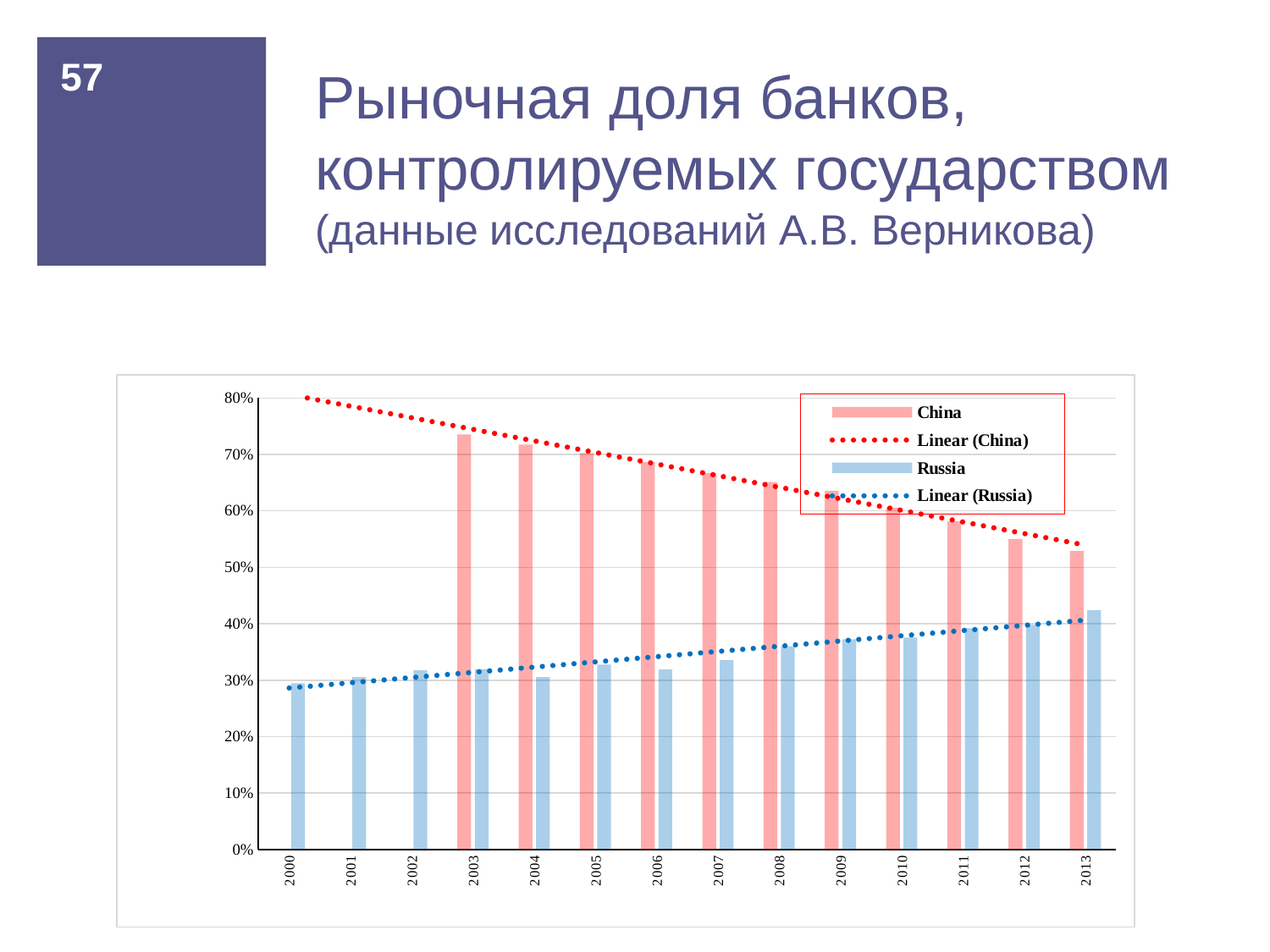
In which year does the first China bar appear on the chart? 2003 Do the China bars rise or fall from 2003 to 2013? fall Which is larger in 2008, the value for China or the value for Russia? China Is the value for Russia in 2013 greater or less than 40%? greater In which year is the China bar the highest? 2003 Is the value for China in 2013 greater or less than 60%? less What kind of chart is shown on the slide? bar chart How many years are shown along the x axis of the chart? 14 How many entries does the chart legend list? 4 In which year is the China bar the lowest? 2013 Is the value for China in 2003 greater or less than 70%? greater